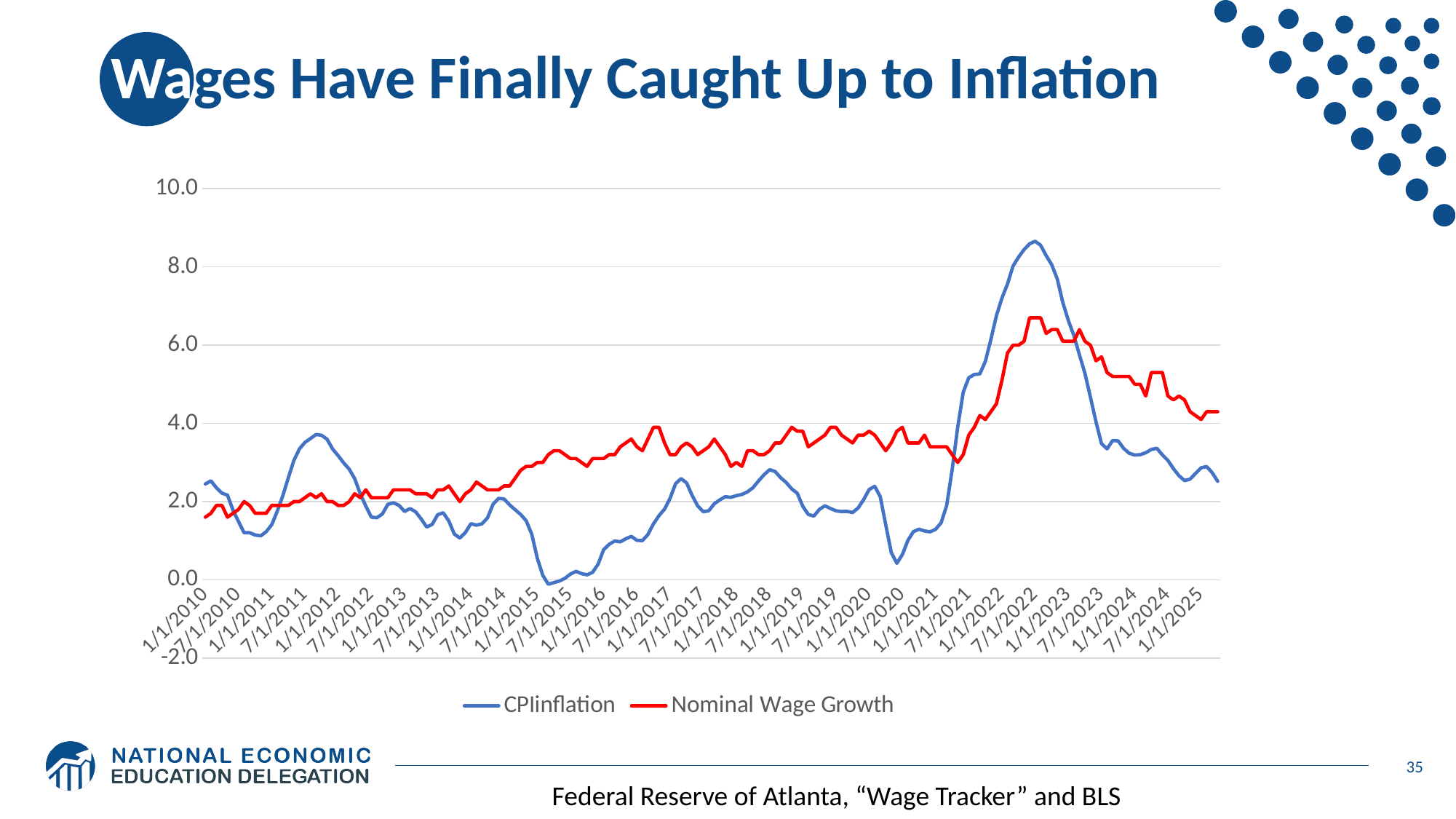
At 7/1/2022, which series has the higher value, CPI inflation or Nominal Wage Growth? CPI inflation Which series is drawn in red? Nominal Wage Growth What kind of chart is shown on the slide? Line chart Which series reaches the highest peak on the chart? CPI inflation Is the value of CPI inflation at 7/1/2015 greater or less than 2.0? less How many series does the legend list? 2 What is the title of the chart on the slide? Wages Have Finally Caught Up to Inflation Is the peak value of CPI inflation around 7/1/2022 greater or less than 8.0? greater Is the peak value of Nominal Wage Growth around 7/1/2022 greater or less than 8.0? less Does CPI inflation rise or fall between 7/1/2022 and 7/1/2023? fall At 1/1/2025, which series has the higher value, CPI inflation or Nominal Wage Growth? Nominal Wage Growth